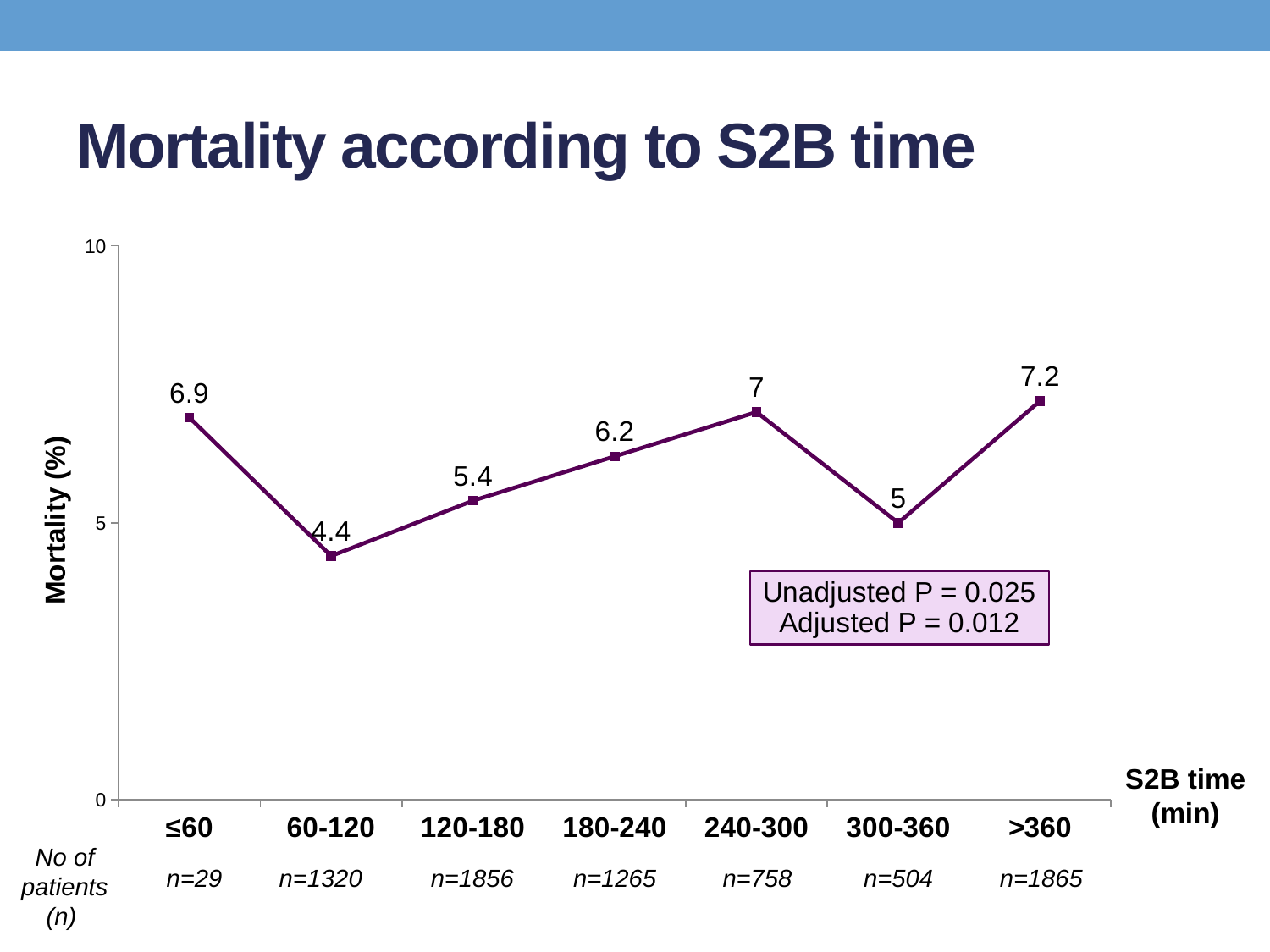
What is the mortality (%) for the 300-360 min S2B time group? 5 How many S2B time groups are plotted on the chart? 7 Does mortality rise or fall from the 60-120 group to the 240-300 group? rise Which S2B time group has the highest mortality? >360 What is the adjusted P value shown on the chart? 0.012 Which has higher mortality: the 120-180 group or the 180-240 group? 180-240 What is the difference in mortality (%) between the >360 group and the 60-120 group? 2.8 What is the mortality (%) for the 60-120 min S2B time group? 4.4 What kind of chart is shown on the slide? line chart What is the mortality (%) for the ≤60 min S2B time group? 6.9 Which S2B time group has the lowest mortality? 60-120 Is the mortality for the 240-300 group greater or less than 5? greater